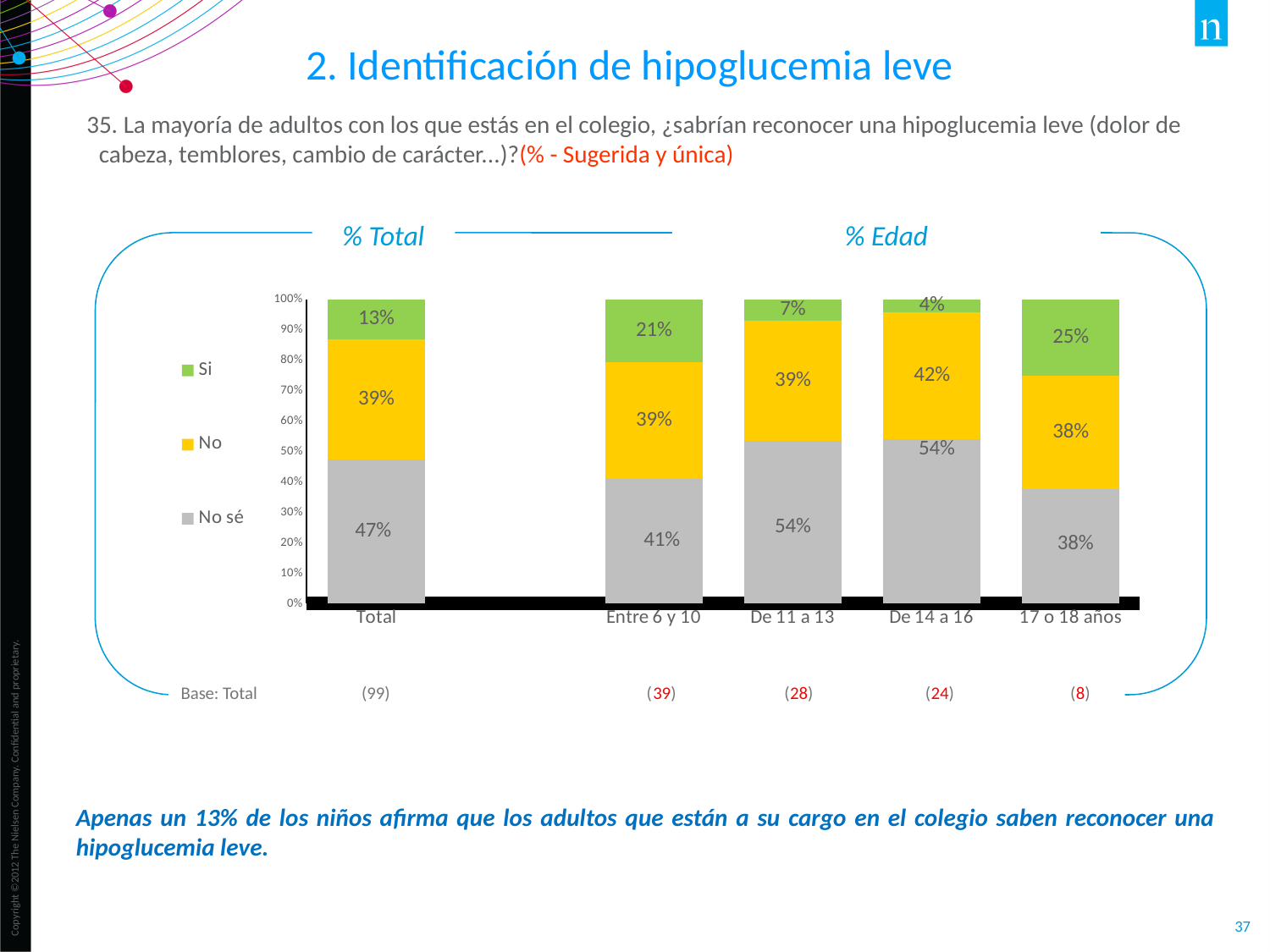
Which category has the highest 'Si' value? 17 o 18 años What is the value of 'Si' for the Total category? 13% What is the difference between the 'Si' value for '17 o 18 años' and the 'Si' value for 'Entre 6 y 10'? 4% How many series does the legend list? 3 Which is larger: the 'No sé' value for 'Entre 6 y 10' or the 'No sé' value for 'De 11 a 13'? De 11 a 13 What is the value of 'No sé' for the 'De 11 a 13' category? 54% What kind of chart is shown on the slide? Stacked bar chart Which category has the lowest 'Si' value? De 14 a 16 How many categories are shown on the x axis? 5 What is the value of 'No' for the 'De 14 a 16' category? 42% Which legend entry is shown in green? Si What is the difference between the 'No sé' value for Total and the 'Si' value for Total? 34%